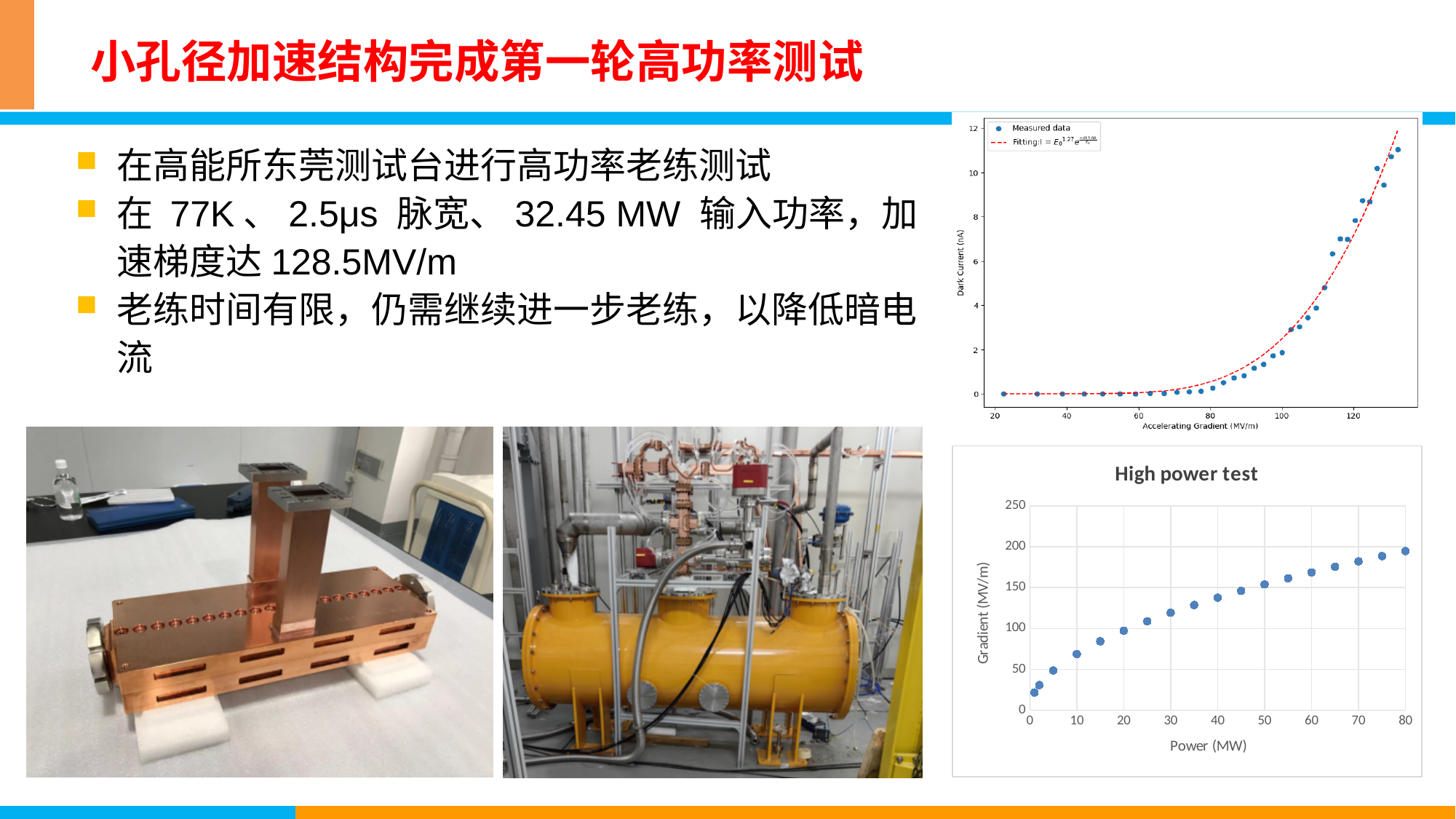
In the 'High power test' chart, what is the label of the y axis? Gradient (MV/m) In the 'High power test' chart, what is the label of the x axis? Power (MW) In the top-right dark current chart, is the measured dark current at 100 MV/m greater or less than 4 nA? less How many series does the legend of the top-right dark current chart list? 2 In the 'High power test' chart, is the gradient at 40 MW greater or less than 100 MV/m? greater In the 'High power test' chart, at which power value is the gradient highest? 80 MW In the 'High power test' chart, does the gradient rise or fall as power increases? rise In the 'High power test' chart, which has the larger gradient: the point at 20 MW or the point at 60 MW? 60 MW In the top-right dark current chart, is the measured dark current at 120 MV/m greater or less than 6 nA? greater In the top-right dark current chart, does the dark current rise or fall as the accelerating gradient increases? rise What kind of chart is the 'High power test' chart at the bottom right? scatter chart